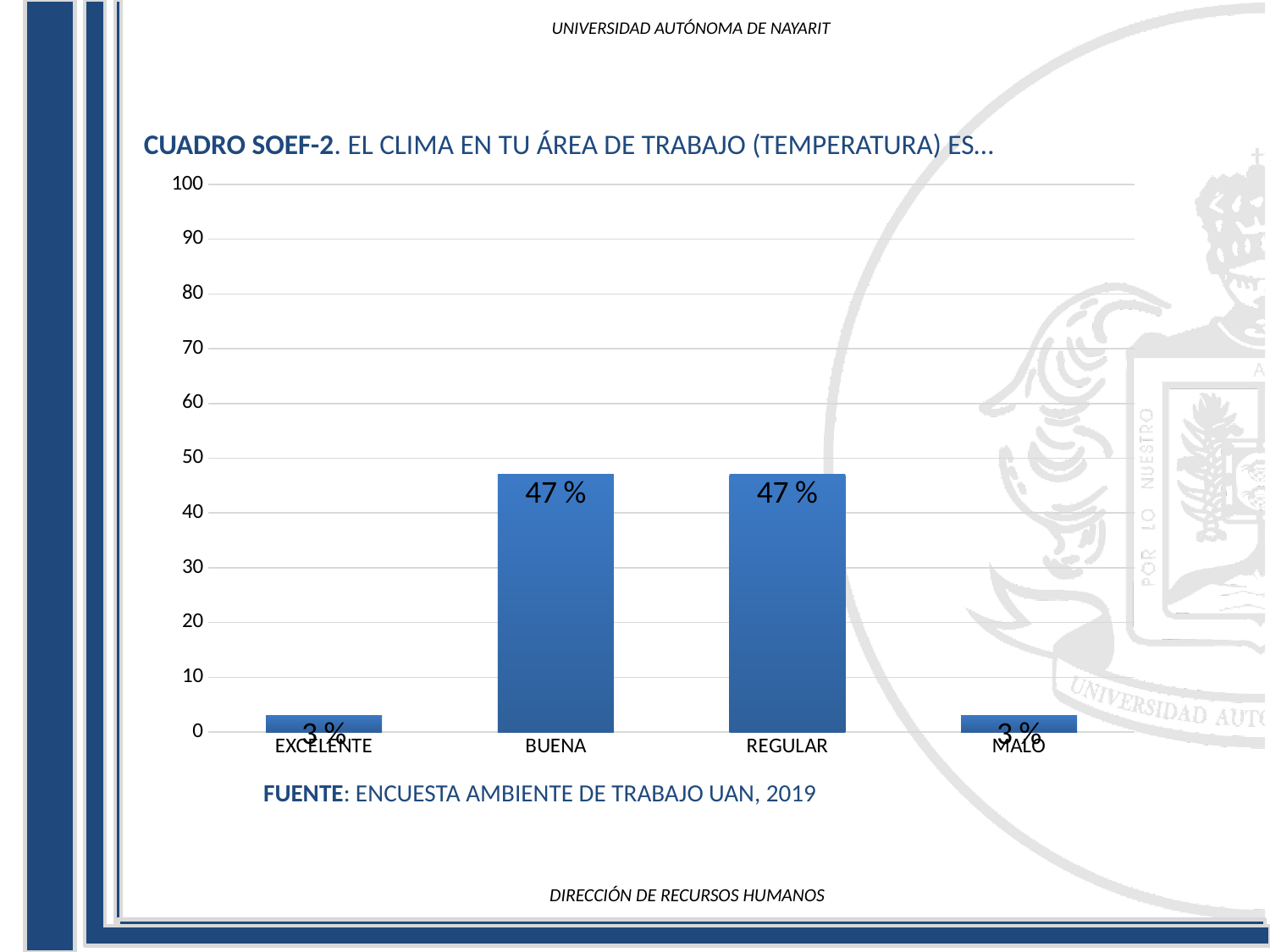
How many categories are shown on the x axis? 4 What kind of chart is shown on the slide? bar chart What is the value for EXCELENTE? 3 % What is the value for BUENA? 47 % Is the value for MALO greater or less than 10? less What is the difference between the values for REGULAR and EXCELENTE? 44 % What is the source cited below the chart? ENCUESTA AMBIENTE DE TRABAJO UAN, 2019 What is the value for REGULAR? 47 % Which is larger, the value for BUENA or the value for MALO? BUENA What is the value for MALO? 3 % Which is larger, the value for EXCELENTE or the value for REGULAR? REGULAR Is the value for BUENA greater or less than 50? less